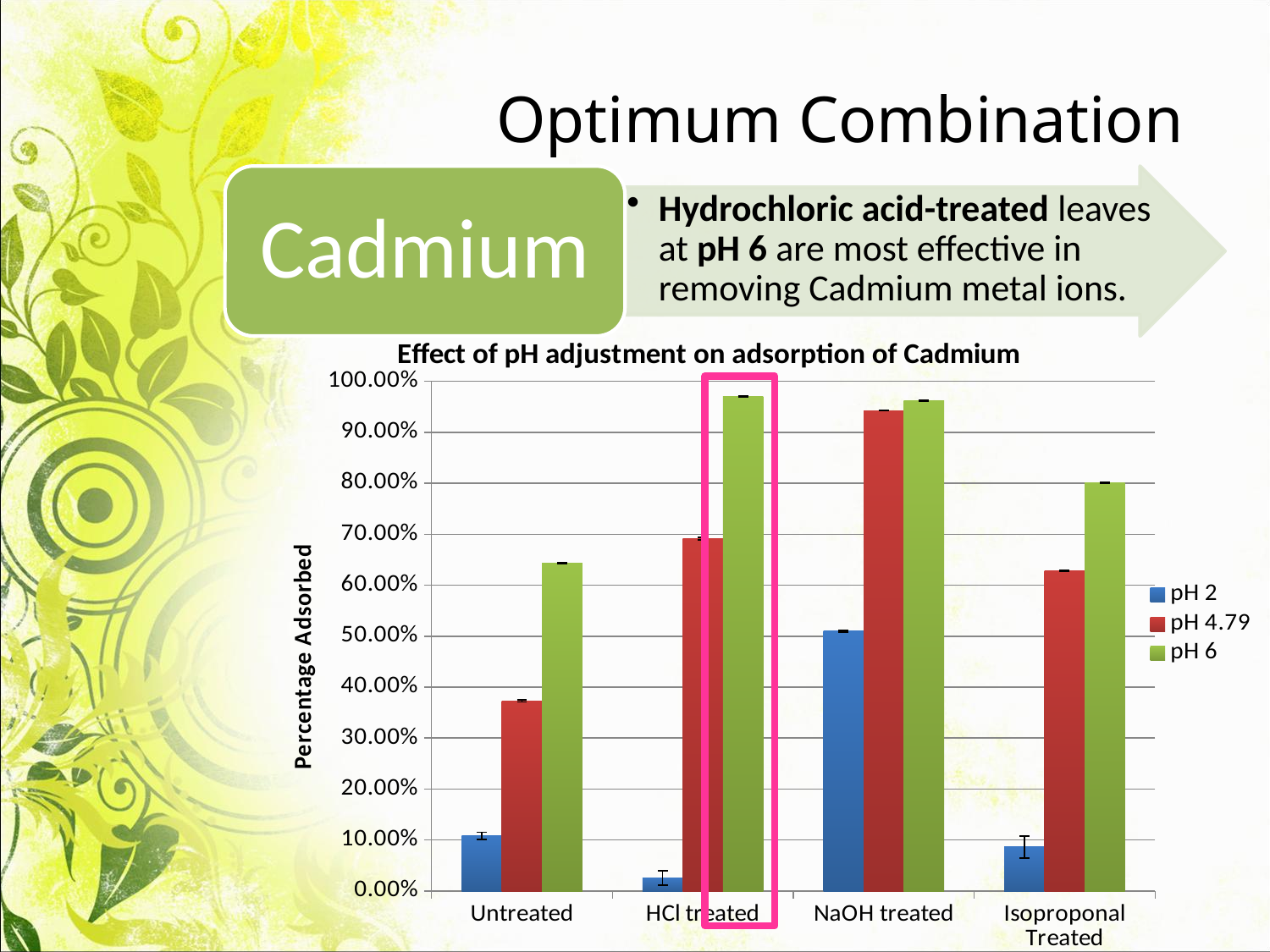
Is the pH 6 value for Untreated greater or less than 60.00%? greater How many treatment categories are shown on the x axis of the chart? 4 Which treatment category has the highest pH 2 bar? NaOH treated How many series does the chart legend list? 3 What is the title of the chart? Effect of pH adjustment on adsorption of Cadmium What kind of chart is shown on the slide? bar chart Which treatment category has the highest pH 4.79 bar? NaOH treated Is the pH 6 value for Isoproponal Treated greater or less than 70.00%? greater Which treatment category has the lowest pH 2 bar? HCl treated What is the label on the vertical axis of the chart? Percentage Adsorbed Is the pH 4.79 value for Untreated greater or less than 40.00%? less Which is larger: the pH 4.79 value for HCl treated or the pH 6 value for Isoproponal Treated? pH 6 value for Isoproponal Treated